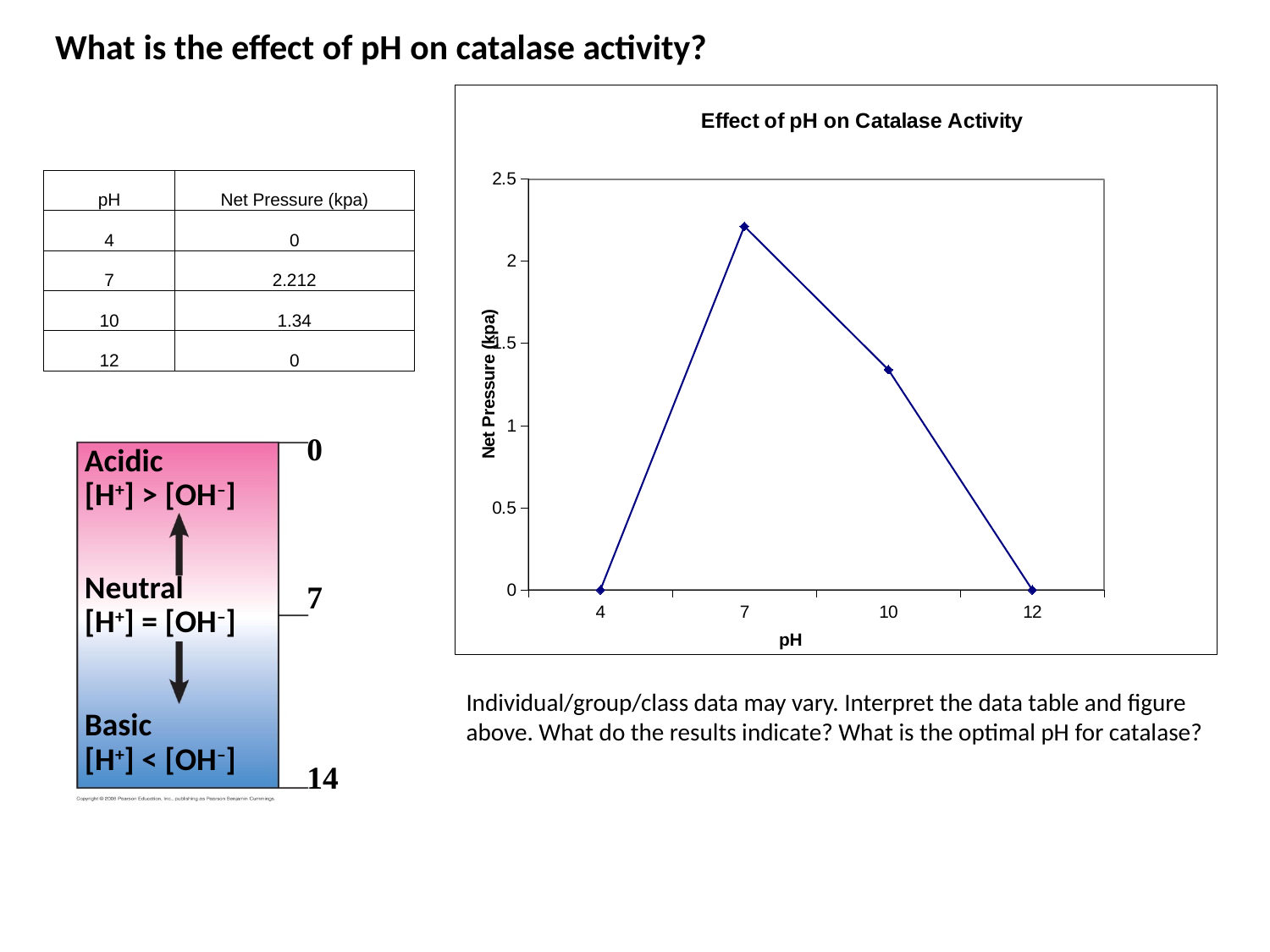
Does the net pressure rise or fall between pH 7 and pH 12? fall What is the net pressure (kpa) at pH 4? 0 What is the title of the chart? Effect of pH on Catalase Activity At which pH is the net pressure highest? 7 How many pH values are plotted on the chart? 4 What is the difference in net pressure between pH 7 and pH 10? 0.872 What is the net pressure (kpa) at pH 10? 1.34 Which has a larger net pressure, pH 7 or pH 10? pH 7 What is the net pressure (kpa) at pH 7? 2.212 What kind of chart is shown on the slide? line chart Is the net pressure at pH 10 greater or less than 1.5? less Is the net pressure at pH 7 greater or less than 2? greater